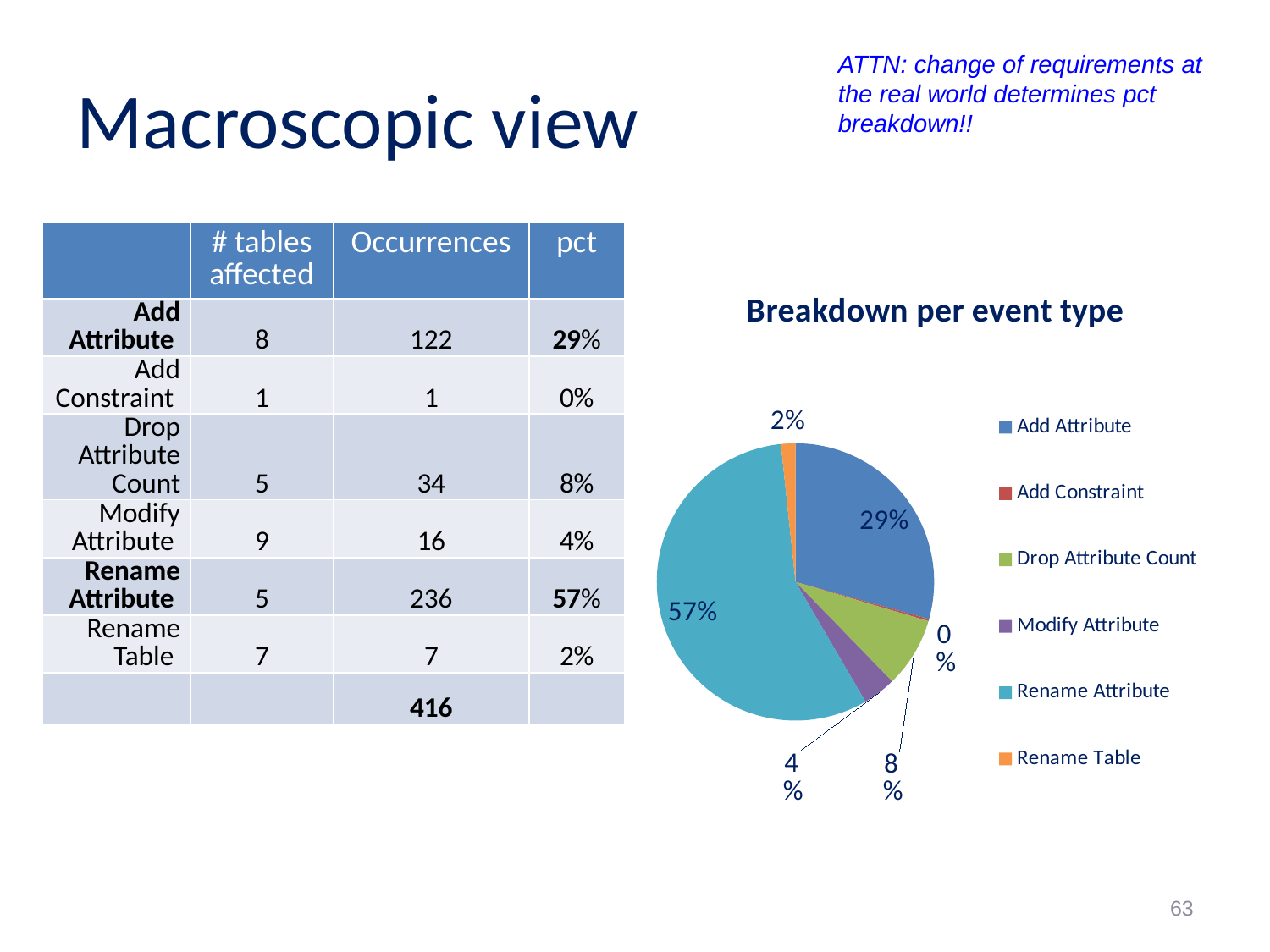
Which event type has the largest slice of the pie? Rename Attribute What share of the pie does Rename Table have? 2% Which event type has the smallest slice of the pie? Add Constraint What share of the pie does Modify Attribute have? 4% What share of the pie does Add Attribute have? 29% Which slice is larger, Drop Attribute Count or Modify Attribute? Drop Attribute Count What is the difference in percentage points between the Rename Attribute slice and the Add Attribute slice? 28 What is the title of the chart? Breakdown per event type How many categories does the legend of the pie chart list? 6 What kind of chart is shown on the slide? pie chart